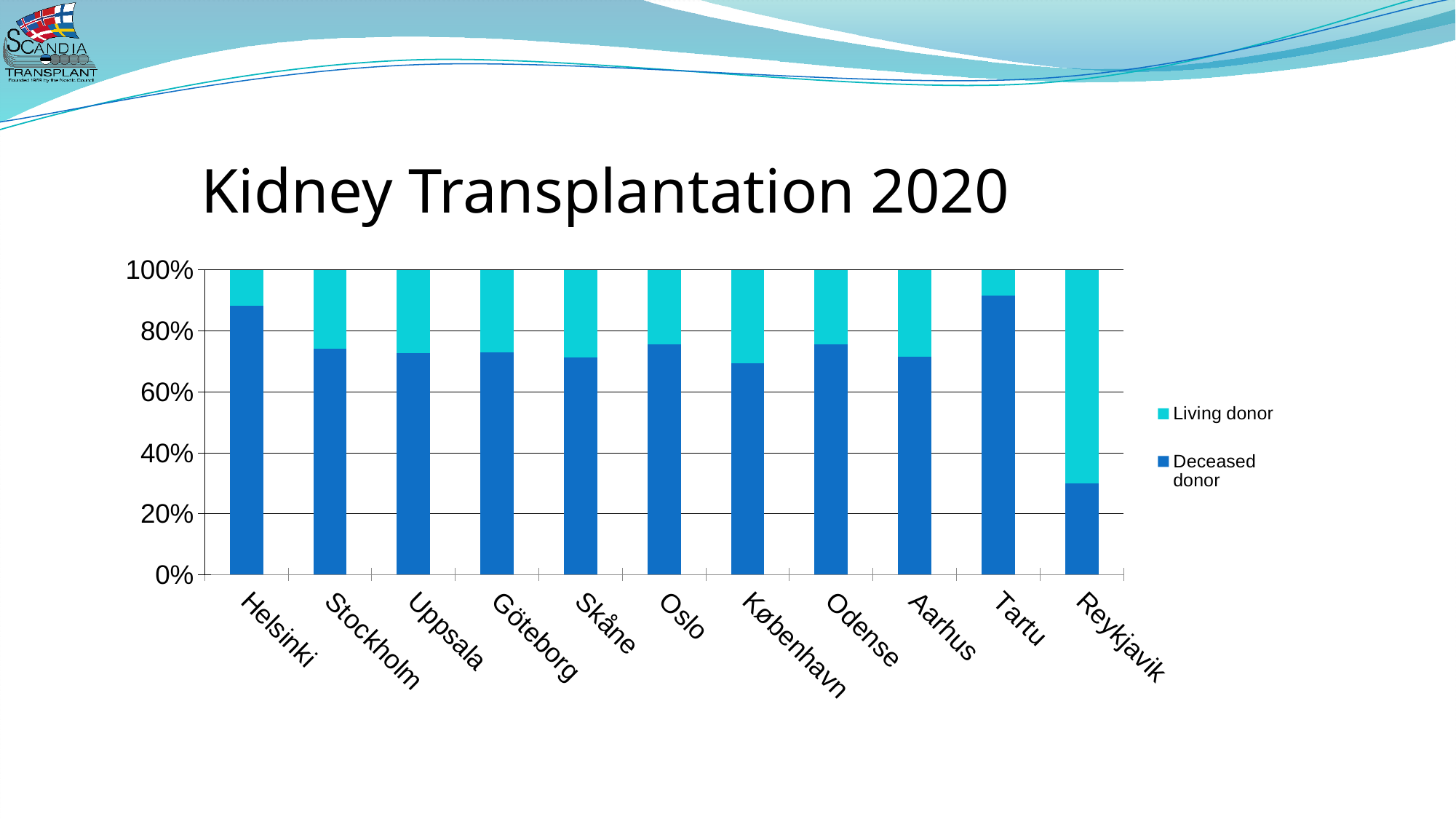
How many series does the chart's legend list? 2 How many transplant centres are shown on the x axis of the chart? 11 Which centre has the smallest deceased donor share? Reykjavik Which centre has the largest living donor share? Reykjavik Is the deceased donor share for Reykjavik greater or less than 40%? less Is the deceased donor share for Helsinki greater or less than 80%? greater What is the title of the chart on the slide? Kidney Transplantation 2020 Which series is shown in the lighter turquoise colour in the chart? Living donor What kind of chart is shown on the slide? Stacked bar chart Is the deceased donor share for København greater or less than 60%? greater Which has the larger deceased donor share, Helsinki or Stockholm? Helsinki Which centre has the largest deceased donor share? Tartu